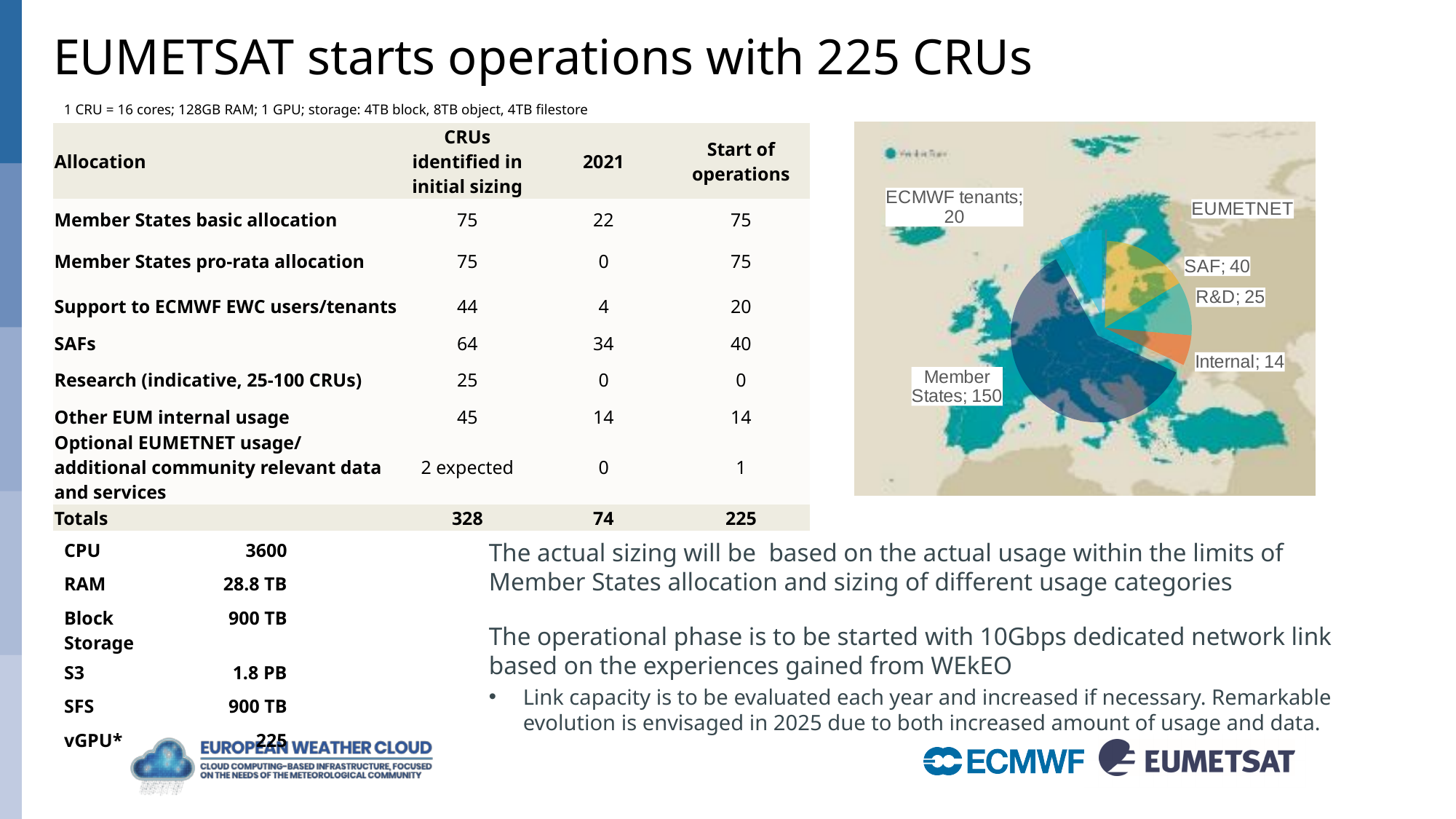
In the pie chart, what value is shown for SAF? 40 What colour is the Member States slice in the pie chart? dark blue In the pie chart, what value is shown for ECMWF tenants? 20 What kind of chart is shown on the map of Europe? pie chart In the pie chart, what is the difference between the Member States value and the SAF value? 110 In the pie chart, what value is shown for Member States? 150 In the pie chart, which is larger, SAF or R&D? SAF Which slice of the pie chart is the largest? Member States In the pie chart, what value is shown for R&D? 25 In the pie chart, what is the difference between the SAF value and the Internal value? 26 In the pie chart, what value is shown for Internal? 14 How many labelled slices does the pie chart have? 6